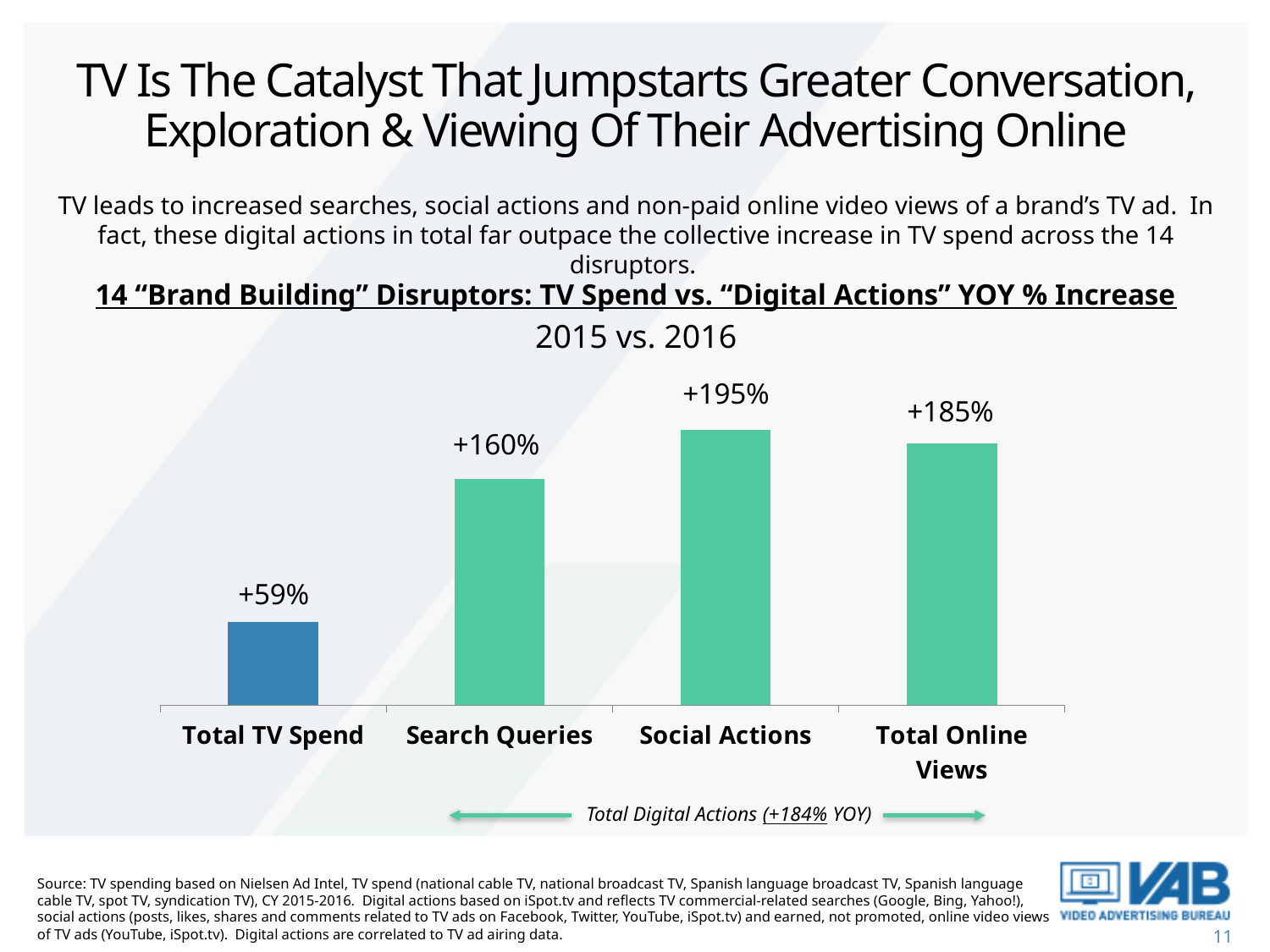
Which category has the highest YOY % increase? Social Actions What is the YOY % increase for Total TV Spend? +59% Which category has the lowest YOY % increase? Total TV Spend What is the YOY % increase for Total Online Views? +185% What kind of chart is shown on the slide? Bar chart What is the YOY % increase for Social Actions? +195% How many categories are shown in the chart? 4 What is the YOY % increase for Search Queries? +160% What is the YOY % increase for Total Digital Actions noted below the chart? +184% What is the difference in percentage points between the Total Online Views and Search Queries increases? 25 What is the difference in percentage points between the Social Actions and Total TV Spend increases? 136 Which has a larger YOY % increase, Search Queries or Total Online Views? Total Online Views